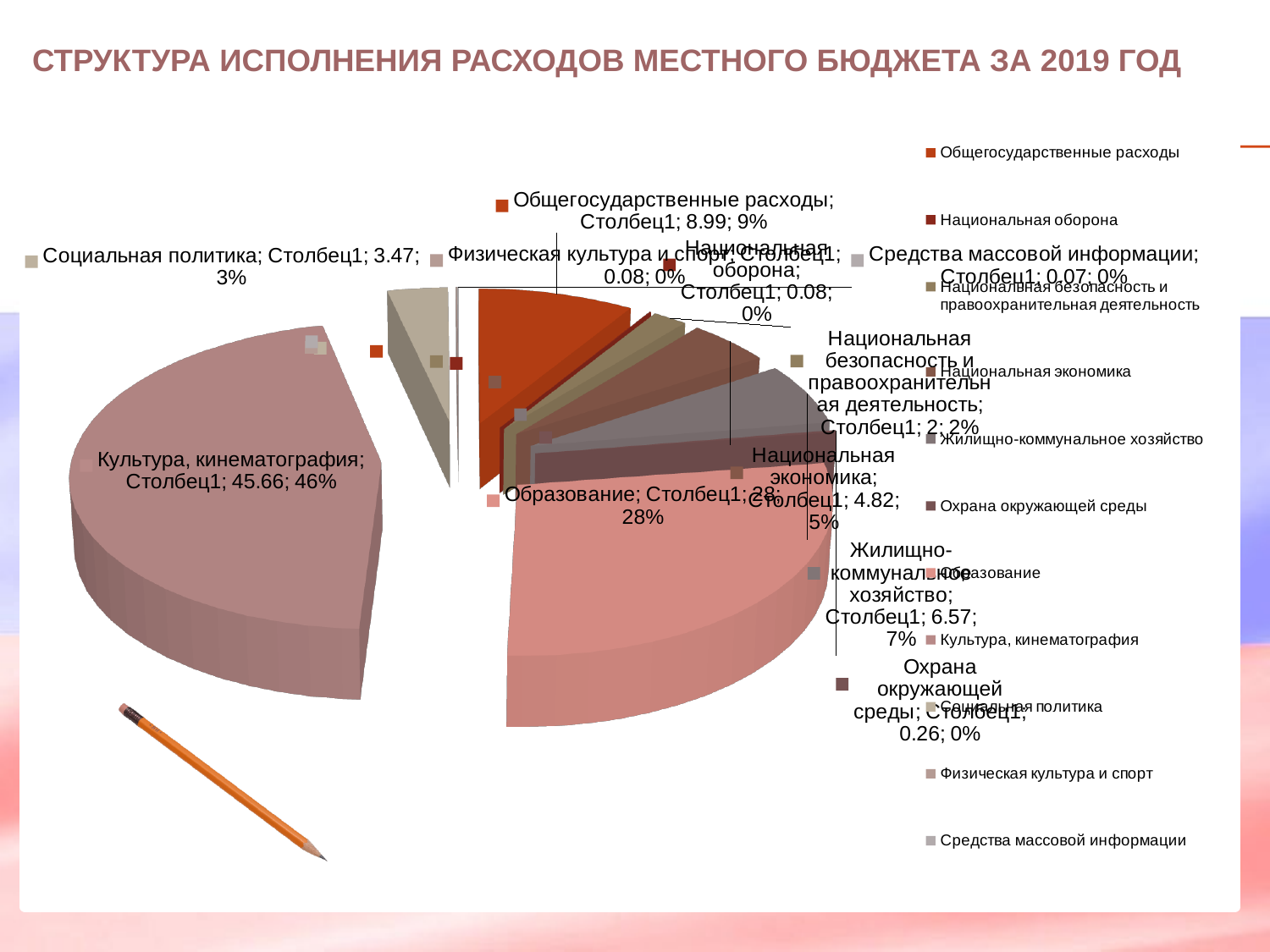
What kind of chart is shown on the slide? Pie chart What value is shown for Образование? 28 What is the difference between the values for Культура, кинематография and Образование? 17.66 What is the title of the chart on the slide? СТРУКТУРА ИСПОЛНЕНИЯ РАСХОДОВ МЕСТНОГО БЮДЖЕТА ЗА 2019 ГОД Which category has the smallest value in the pie chart? Средства массовой информации Which category has the largest slice of the pie? Культура, кинематография What value is shown for Культура, кинематография? 45.66 Which is larger, the value for Социальная политика or the value for Национальная экономика? Национальная экономика What value is shown for Национальная экономика? 4.82 What value is shown for Жилищно-коммунальное хозяйство? 6.57 What share of the pie does Общегосударственные расходы represent? 9% How many categories does the legend of the pie chart list? 11